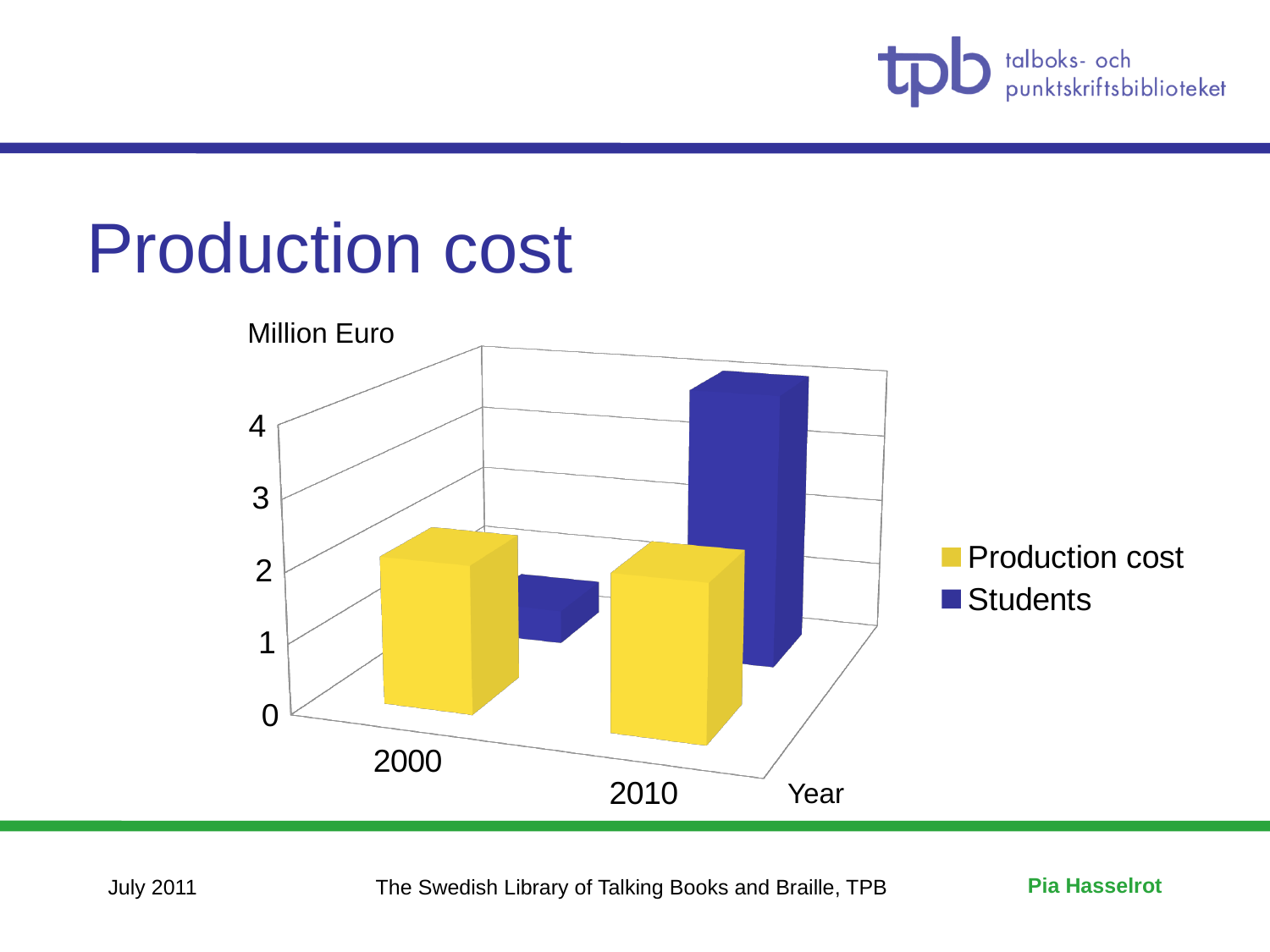
How many years are shown on the x axis? 2 Is the value for Students in 2010 greater or less than 3? greater What kind of chart is shown on the slide? bar chart Is the value for Production cost in 2010 greater or less than 3? less Does the Students series rise or fall from 2000 to 2010? rise What is the title of the chart? Production cost How many series does the legend list? 2 In 2000, which is larger: Production cost or Students? Production cost What unit is shown on the vertical axis label? Million Euro In which year is the Students value highest? 2010 In 2010, which is larger: Production cost or Students? Students Is the value for Production cost in 2000 greater or less than 1? greater